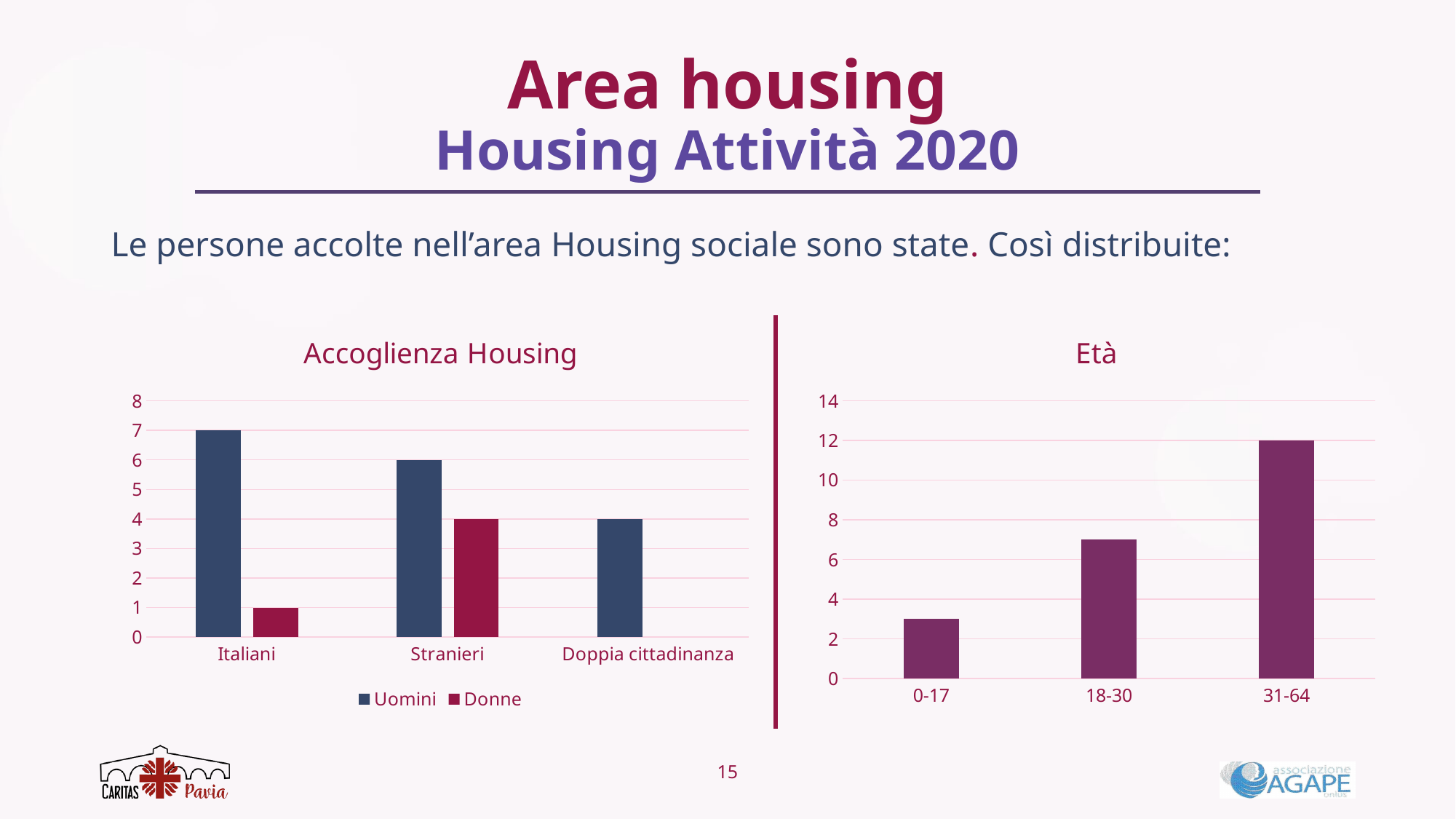
In the 'Età' chart, is the value for 0-17 greater or less than 4? less In the 'Accoglienza Housing' chart, what is the value for Donne in the Stranieri category? 4 In the 'Accoglienza Housing' chart, what is the value for Uomini in the Doppia cittadinanza category? 4 In the 'Accoglienza Housing' chart, what is the value for Uomini in the Italiani category? 7 How many series does the legend of the 'Accoglienza Housing' chart list? 2 In the 'Età' chart, do the values rise or fall from 0-17 to 31-64? rise In the 'Accoglienza Housing' chart, which category has the highest Uomini value? Italiani In the 'Accoglienza Housing' chart, what is the difference between Uomini and Donne in the Italiani category? 6 What kind of chart is the 'Età' chart? bar chart How many categories are shown on the x axis of the 'Età' chart? 3 In the 'Età' chart, what is the value for the 31-64 category? 12 In the 'Accoglienza Housing' chart, which is larger for Stranieri: Uomini or Donne? Uomini